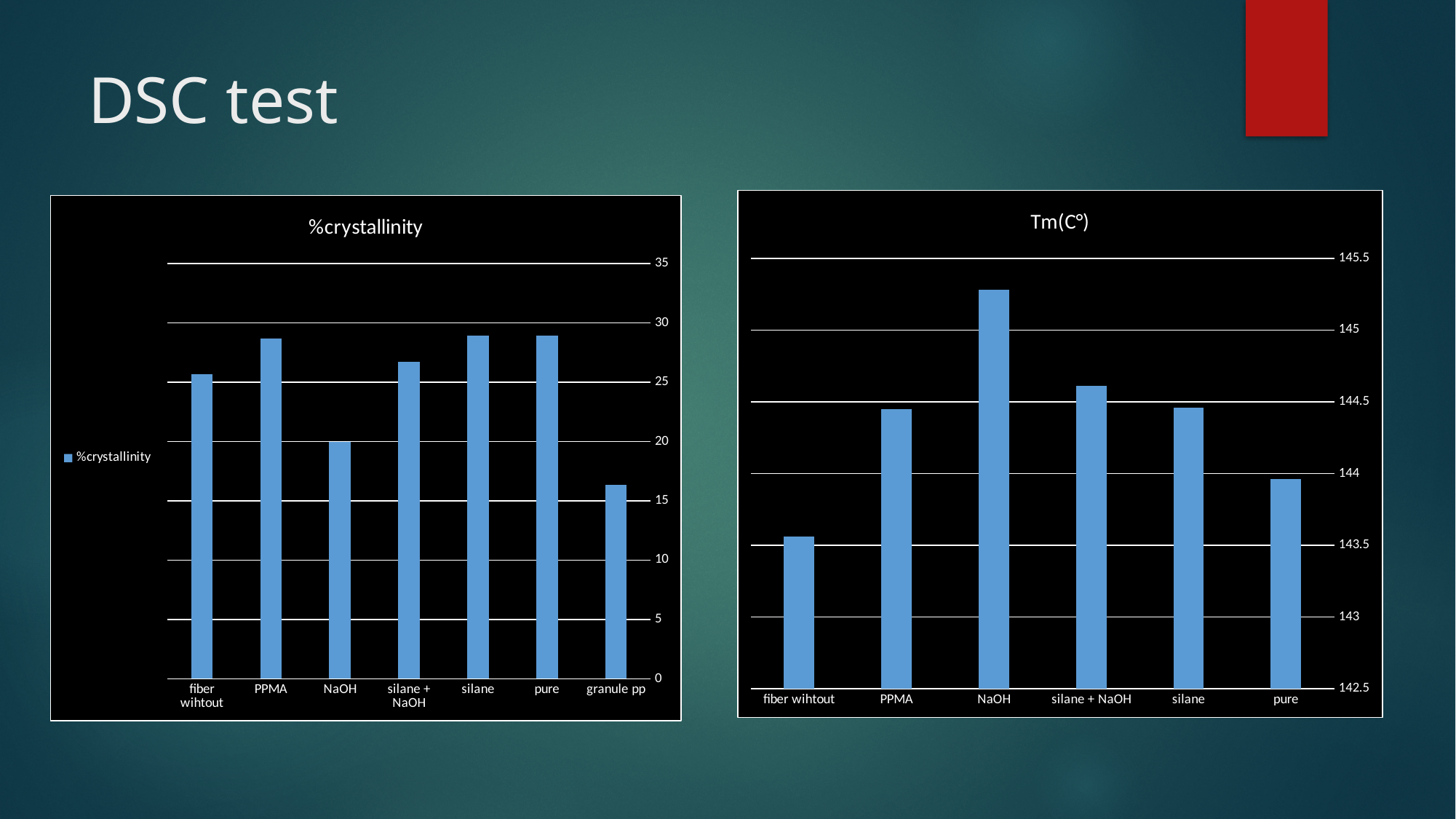
In the %crystallinity chart, how many categories are shown on the x axis? 7 In the Tm(C°) chart, which category has the highest value? NaOH In the %crystallinity chart, which category has the lowest value? granule pp What kind of chart is the %crystallinity chart on the left? bar chart In the Tm(C°) chart, how many categories are shown on the x axis? 6 In the Tm(C°) chart, which category has the lowest value? fiber wihtout In the %crystallinity chart, how many series does the legend list? 1 In the Tm(C°) chart, is the value for NaOH greater or less than 145? greater What is the title of the chart on the right of the slide? Tm(C°) In the %crystallinity chart, is the value for granule pp greater or less than 20? less In the %crystallinity chart, which is larger, the value for PPMA or the value for NaOH? PPMA In the %crystallinity chart, is the value for silane + NaOH greater or less than 25? greater